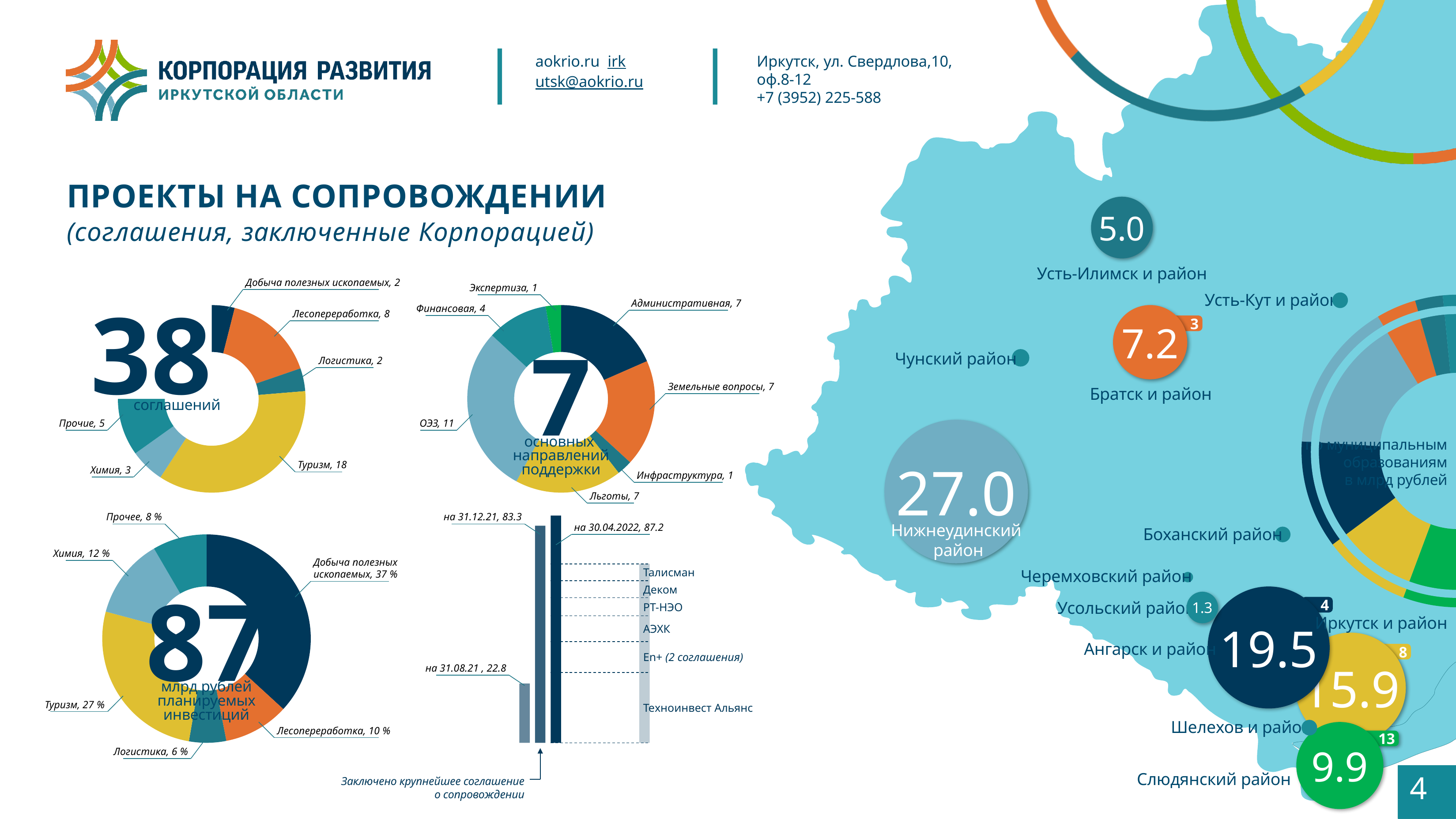
In the donut chart titled '7 основных направлений поддержки', which direction has the highest value? ОЭЗ In the donut chart titled '7 основных направлений поддержки', what is the value for Финансовая? 4 In the donut chart titled '7 основных направлений поддержки', what is the value for ОЭЗ? 11 In the top-left donut chart (38 соглашений), how many agreements are in the Туризм category? 18 In the top-left donut chart (38 соглашений), which category has the most agreements? Туризм In the bottom-left donut chart (87 млрд рублей планируемых инвестиций), which is larger: Химия or Прочее? Химия In the bottom-left donut chart (87 млрд рублей планируемых инвестиций), what share is Добыча полезных ископаемых? 37 % In the bottom-left donut chart (87 млрд рублей планируемых инвестиций), which category has the smallest share? Логистика In the bar chart in the bottom middle of the slide, do the values rise or fall from 31.08.21 to 30.04.2022? rise In the bar chart in the bottom middle of the slide, what is the value for на 30.04.2022? 87.2 In the top-left donut chart (38 соглашений), what is the difference between Туризм and Лесопереработка? 10 In the bar chart in the bottom middle of the slide, what is the difference between the values for на 30.04.2022 and на 31.12.21? 3.9